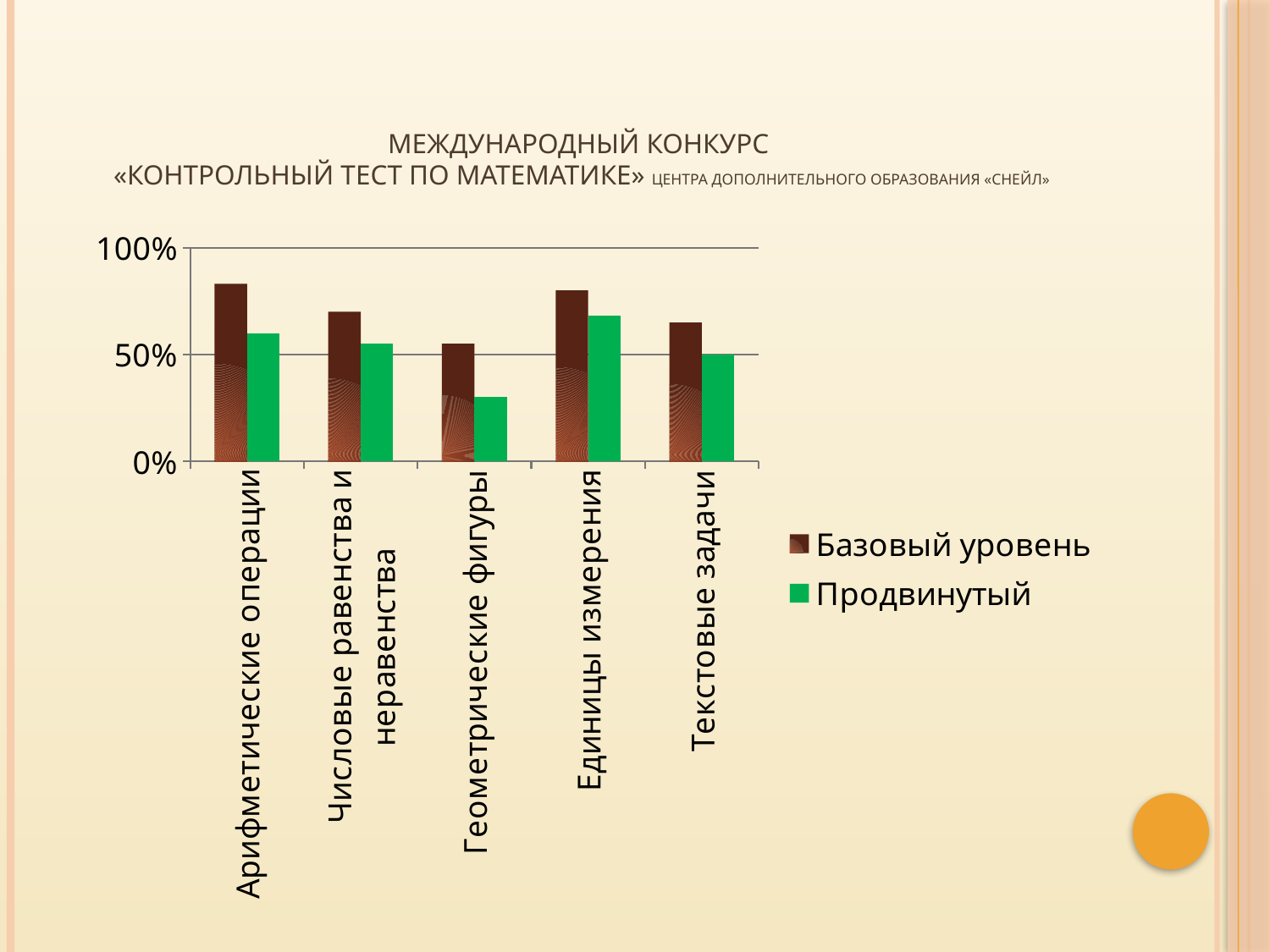
Which is larger: the Базовый уровень value for Арифметические операции or the Базовый уровень value for Геометрические фигуры? Арифметические операции How many categories are shown on the x axis of the chart? 5 Is the Продвинутый value for Единицы измерения greater or less than 50%? greater How many series does the chart legend list? 2 Is the Продвинутый value for Геометрические фигуры greater or less than 50%? less Which series is shown in green in the chart? Продвинутый Which category has the highest value for the Продвинутый series? Единицы измерения Which category has the lowest value for the Продвинутый series? Геометрические фигуры Is the Базовый уровень value for Арифметические операции greater or less than 50%? greater Which category has the lowest value for the Базовый уровень series? Геометрические фигуры What kind of chart is shown on the slide? bar chart For Геометрические фигуры, which series has the larger value: Базовый уровень or Продвинутый? Базовый уровень